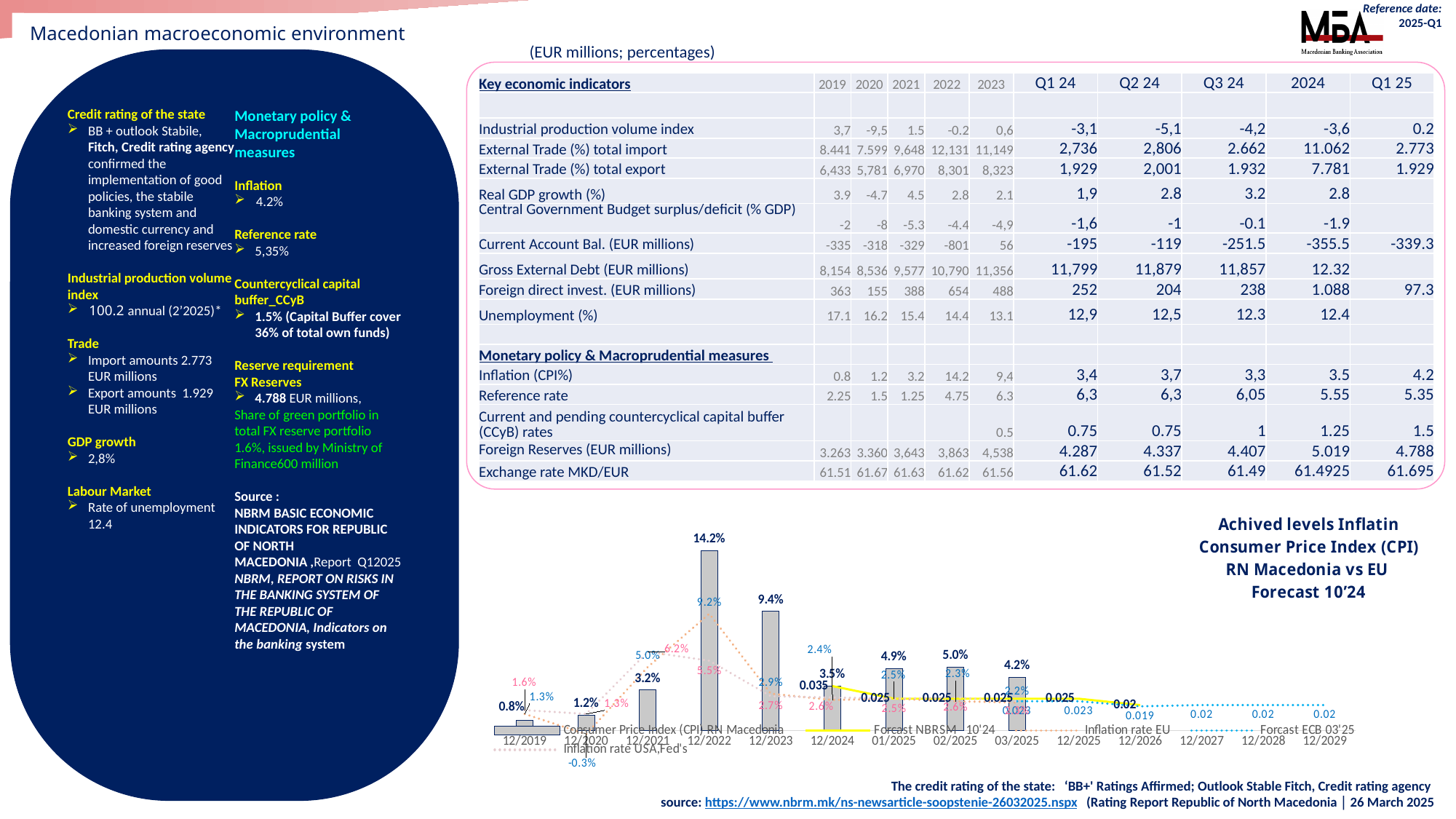
How many bars for Consumer Price Index (CPI) RN Macedonia are plotted in the chart? 9 Which is larger, the CPI RN Macedonia value for 01/2025 or for 03/2025? 01/2025 What is the Consumer Price Index (CPI) RN Macedonia value for 03/2025? 4.2% Do the CPI RN Macedonia bars rise or fall from 12/2022 to 12/2024? fall Which period has the highest Consumer Price Index (CPI) RN Macedonia bar? 12/2022 What is the difference between the CPI RN Macedonia values for 12/2022 and 12/2023? 4.8% What is the Forecast NBRSM 10'24 value at 12/2024? 0.035 How many series does the chart legend list? 5 What kind of chart is shown at the bottom of the slide? bar chart (with line series) What is the Forcast ECB 03'25 value at 12/2026? 0.019 Which period has the lowest Consumer Price Index (CPI) RN Macedonia bar? 12/2019 What is the Consumer Price Index (CPI) RN Macedonia value for 12/2022? 14.2%